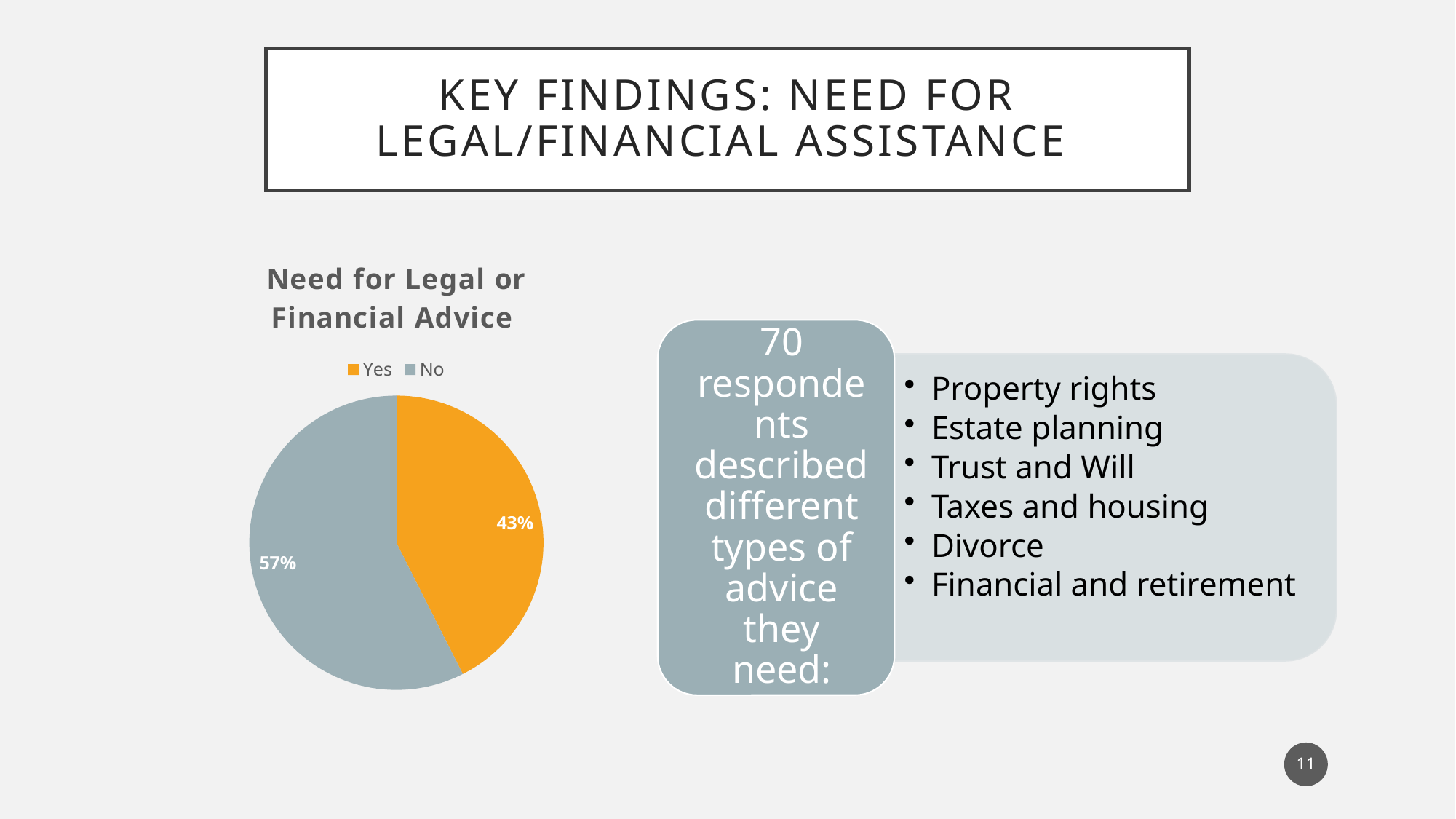
What percentage of respondents answered No to needing legal or financial advice? 57% What share of the pie does the No slice represent? 57% Which slice of the pie chart is smaller, Yes or No? Yes How many slices does the pie chart have? 2 How many entries does the chart legend list? 2 What is the difference in percentage points between the No and Yes slices? 14 What is the title of the chart? Need for Legal or Financial Advice Is the Yes share larger than the No share? No Which colour represents the Yes slice in the pie chart? Orange What percentage of respondents answered Yes to needing legal or financial advice? 43% What type of chart is shown on the slide? Pie chart Which slice of the pie chart is larger, Yes or No? No